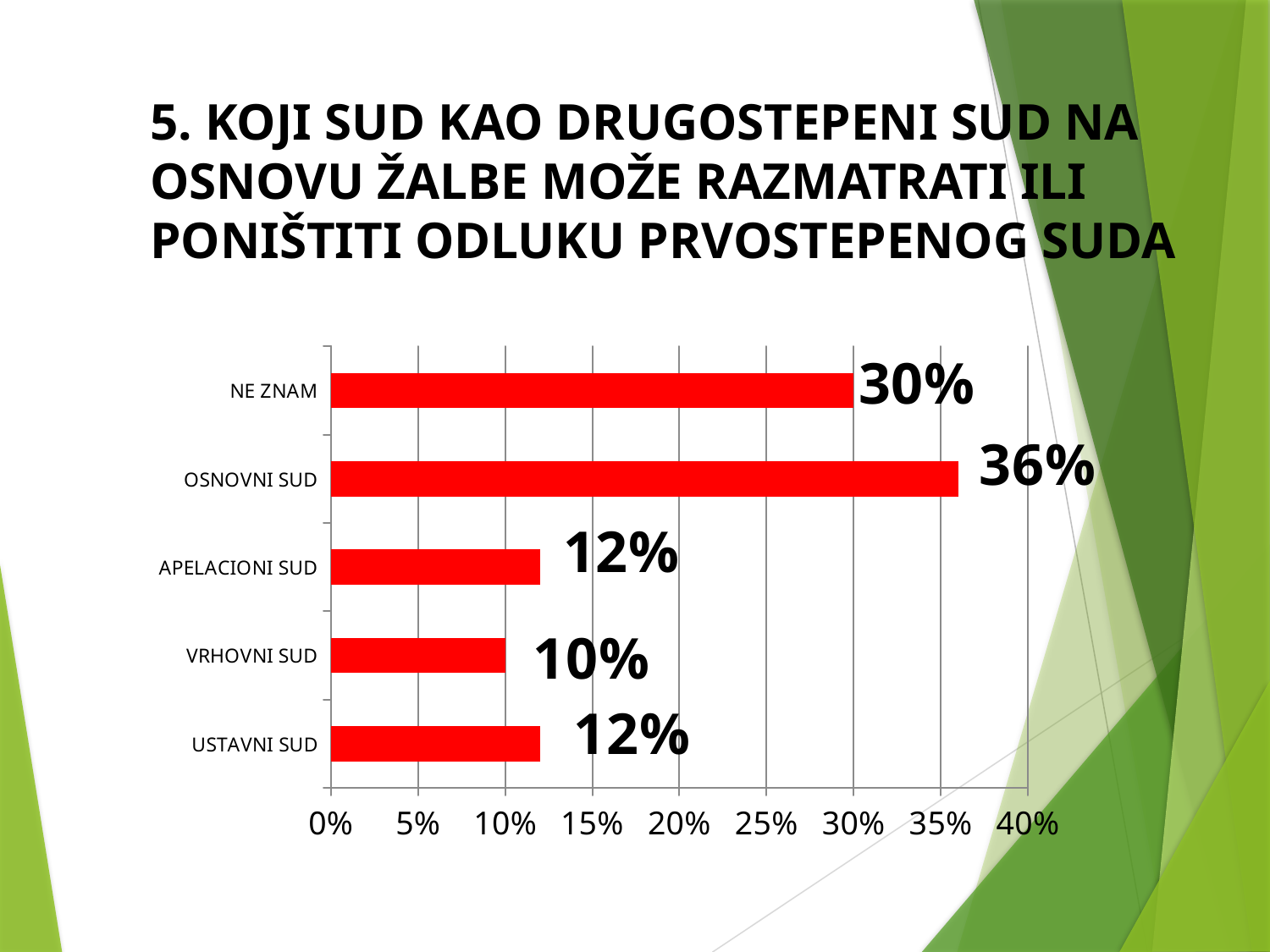
Which category has the highest value? OSNOVNI SUD What is the difference between the values for OSNOVNI SUD and NE ZNAM? 6% Which category has the lowest value? VRHOVNI SUD What kind of chart is shown on the slide? Bar chart Which is larger, the value for NE ZNAM or the value for APELACIONI SUD? NE ZNAM What is the value for APELACIONI SUD? 12% What is the value for NE ZNAM? 30% What colour are the bars in the chart? Red How many categories are shown in the chart? 5 What is the value for OSNOVNI SUD? 36% Is the value for OSNOVNI SUD greater or less than 35%? greater What is the value for VRHOVNI SUD? 10%